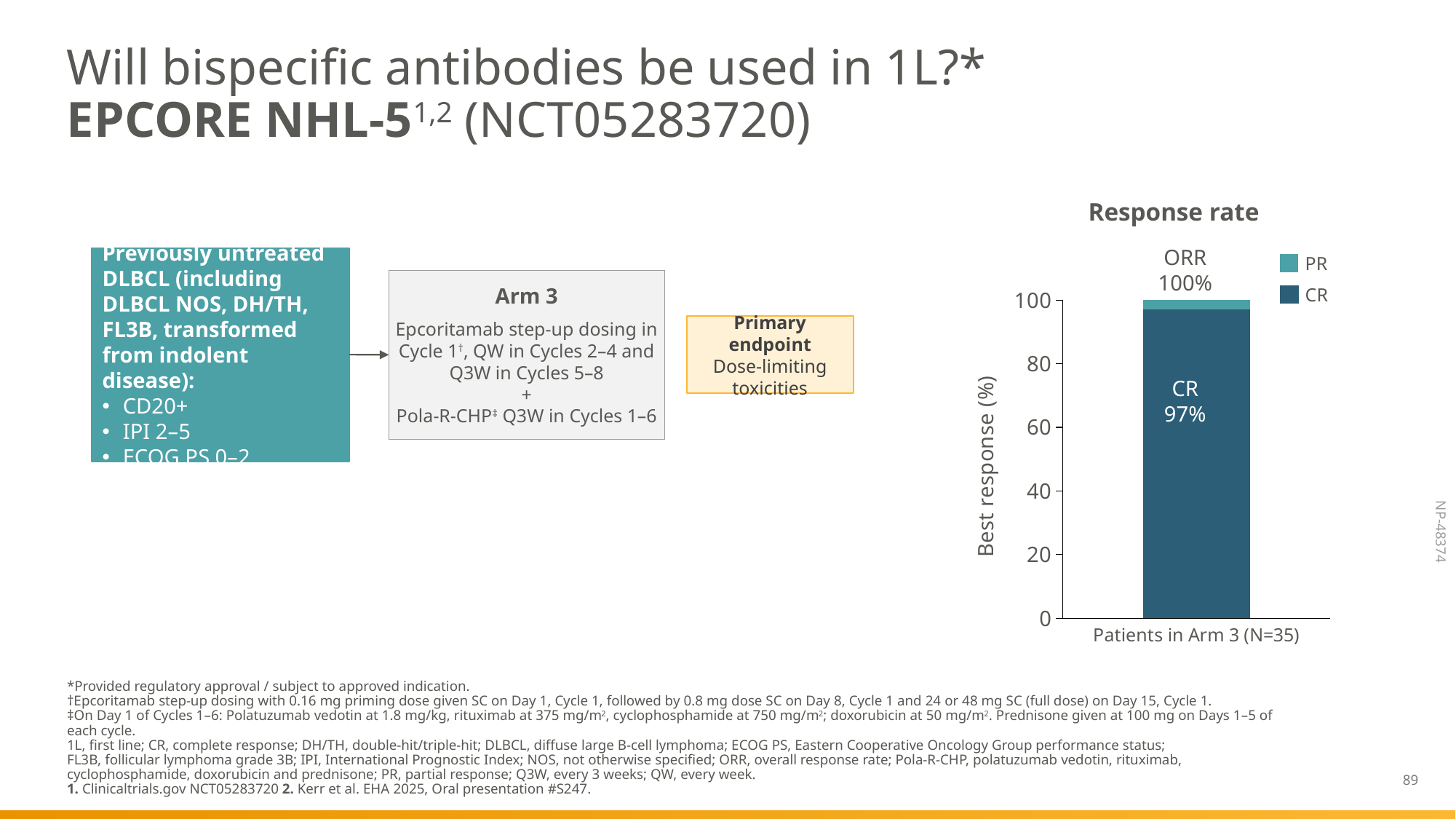
What is the category label on the x axis of the Response rate chart? Patients in Arm 3 (N=35) How many series does the legend of the Response rate chart list? 2 What kind of chart is the Response rate chart? Stacked bar chart What is the total height of the stacked bar in the Response rate chart, as labelled by the ORR? 100% What ORR is shown above the bar in the Response rate chart? 100% How many bars are plotted in the Response rate chart? 1 What is the difference between the ORR and the CR value in the Response rate chart? 3% Which series in the Response rate chart is larger, CR or PR? CR Is the CR value in the Response rate chart greater or less than 80? greater What is the CR value shown on the bar in the Response rate chart? 97% What is the label on the y axis of the Response rate chart? Best response (%)